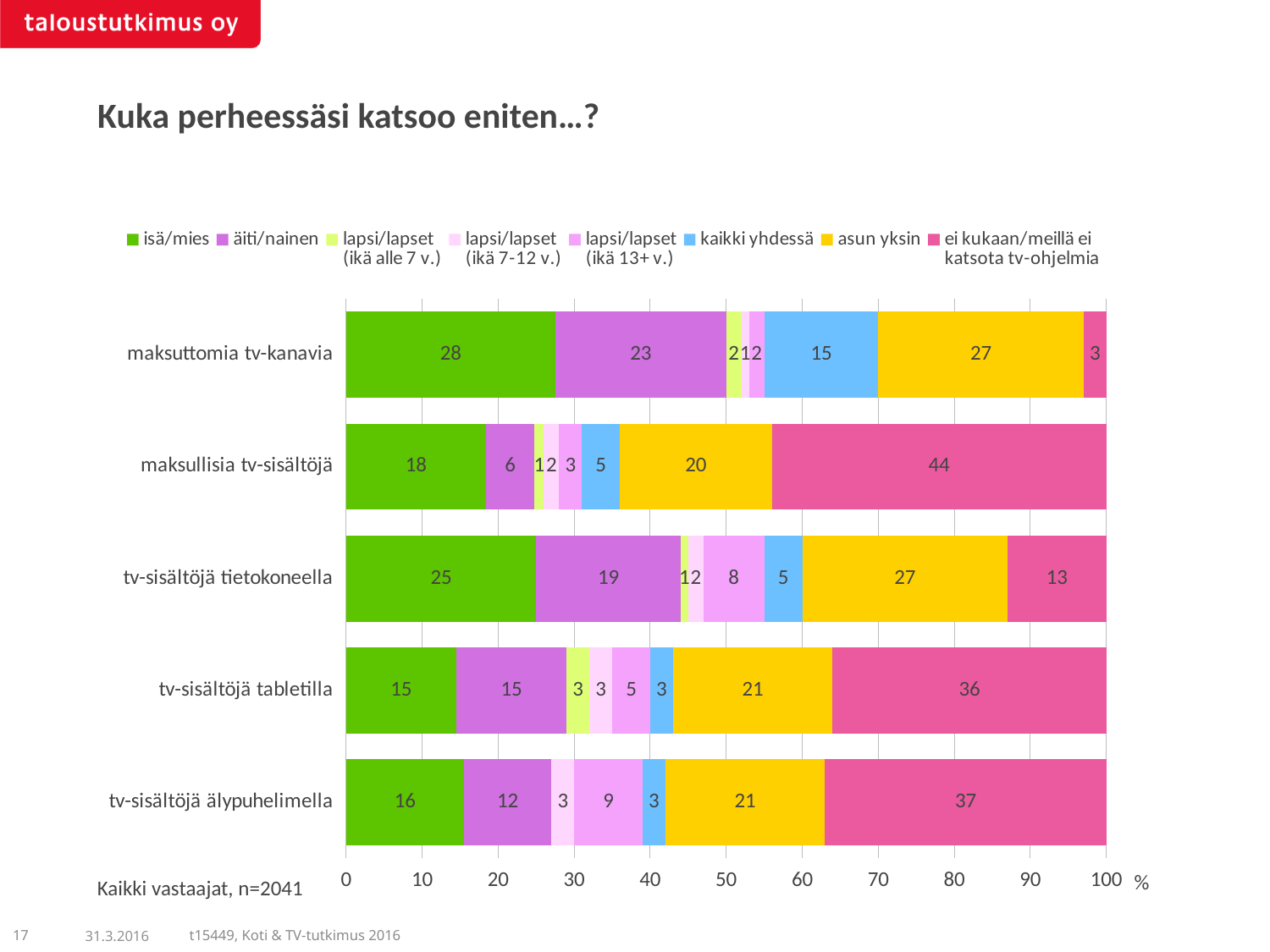
How many categories are shown on the vertical axis? 5 How many series does the legend list? 8 Which category has the lowest value for ei kukaan/meillä ei katsota tv-ohjelmia? maksuttomia tv-kanavia What is the difference between the ei kukaan/meillä ei katsota tv-ohjelmia values for tv-sisältöjä älypuhelimella and tv-sisältöjä tabletilla? 1 What is the value for isä/mies in the maksuttomia tv-kanavia bar? 28 What is the value for asun yksin in the tv-sisältöjä tietokoneella bar? 27 What kind of chart is shown on the slide? stacked bar chart Which is larger: the kaikki yhdessä value for maksuttomia tv-kanavia or for tv-sisältöjä tietokoneella? maksuttomia tv-kanavia What is the title of the chart? Kuka perheessäsi katsoo eniten...? What is the value for äiti/nainen in the tv-sisältöjä älypuhelimella bar? 12 Which category has the highest value for isä/mies? maksuttomia tv-kanavia What is the value for ei kukaan/meillä ei katsota tv-ohjelmia in the maksullisia tv-sisältöjä bar? 44